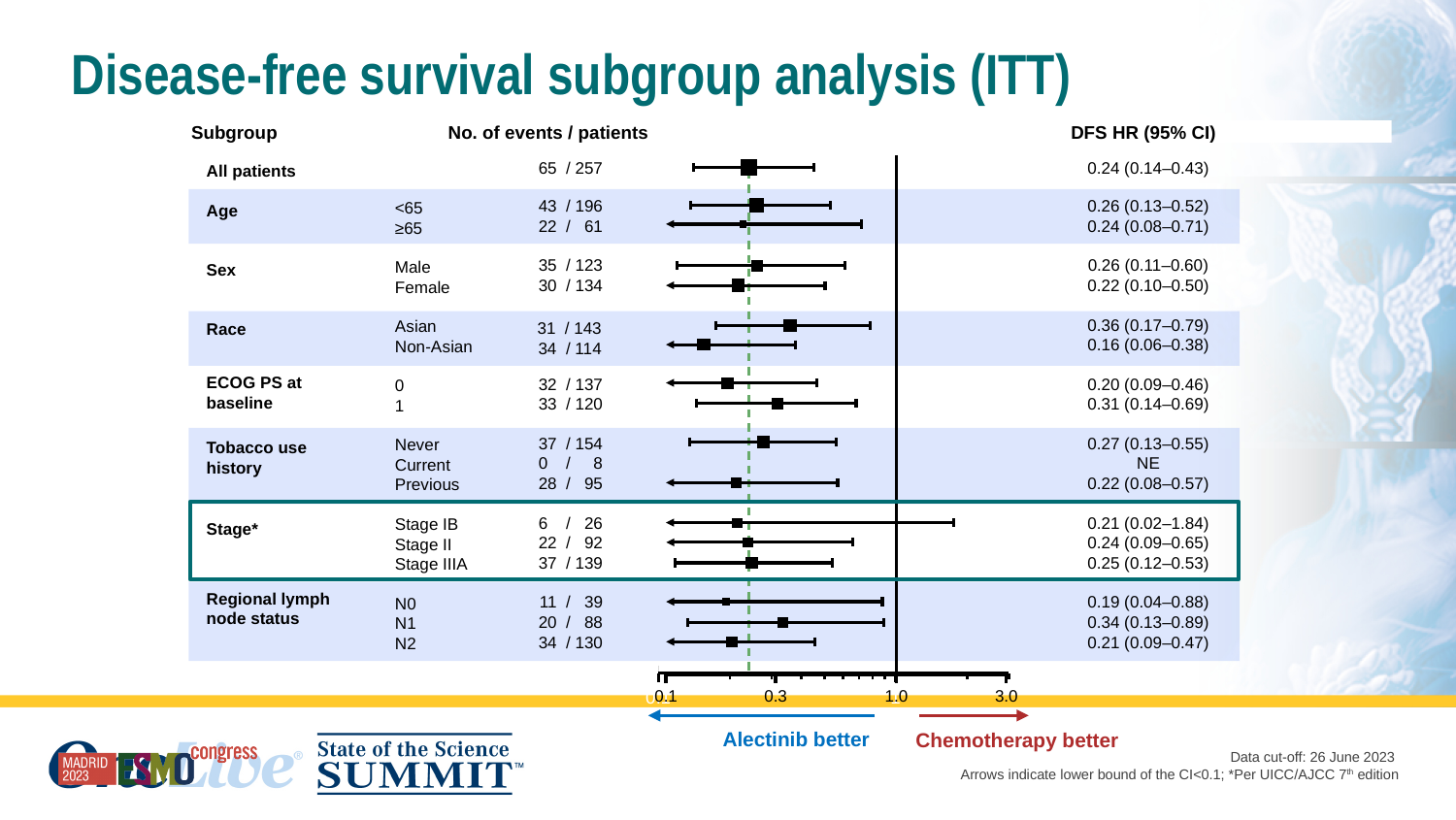
What is the DFS HR (95% CI) for the Non-Asian subgroup? 0.16 (0.06–0.38) Which subgroup has the highest DFS hazard ratio point estimate? Asian What is the DFS HR (95% CI) for Stage IB patients? 0.21 (0.02–1.84) What kind of chart is shown on the slide? Forest plot Is the DFS hazard ratio for all patients greater or less than 1.0? less What is the DFS HR shown for the Current tobacco use subgroup? NE What is the difference between the DFS hazard ratios for the Asian and Non-Asian subgroups? 0.20 What is the DFS HR (95% CI) for the Asian subgroup? 0.36 (0.17–0.79) What is the DFS HR (95% CI) for all patients? 0.24 (0.14–0.43) Which has a larger DFS hazard ratio, ECOG PS 0 or ECOG PS 1? ECOG PS 1 Which subgroup has the lowest DFS hazard ratio point estimate? Non-Asian How many events / patients are reported for all patients? 65 / 257